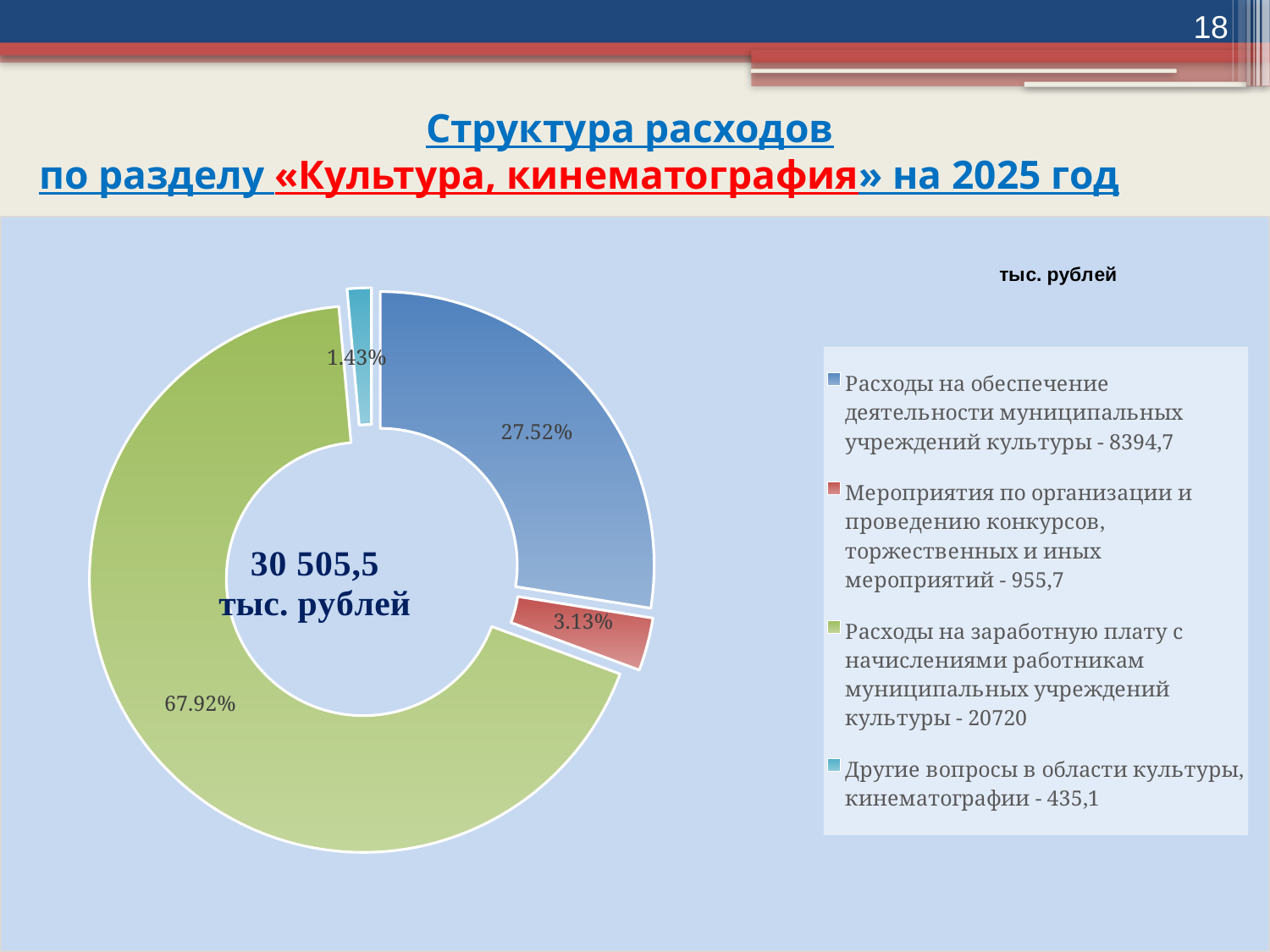
What value (тыс. рублей) is given in the legend for "Другие вопросы в области культуры, кинематографии"? 435,1 How many slices does the doughnut chart have? 4 What total amount is shown in the centre of the doughnut chart? 30 505,5 тыс. рублей What kind of chart is shown on the slide? Doughnut (pie) chart How many entries does the legend list? 4 Which category has the smallest share of the doughnut chart? Другие вопросы в области культуры, кинематографии What percentage share is shown for the slice "Мероприятия по организации и проведению конкурсов, торжественных и иных мероприятий"? 3.13% What percentage share is shown for the slice "Расходы на обеспечение деятельности муниципальных учреждений культуры"? 27.52% What percentage share is shown for the slice "Другие вопросы в области культуры, кинематографии"? 1.43% What value (тыс. рублей) is given in the legend for "Расходы на заработную плату с начислениями работникам муниципальных учреждений культуры"? 20720 Which category has the largest share of the doughnut chart? Расходы на заработную плату с начислениями работникам муниципальных учреждений культуры